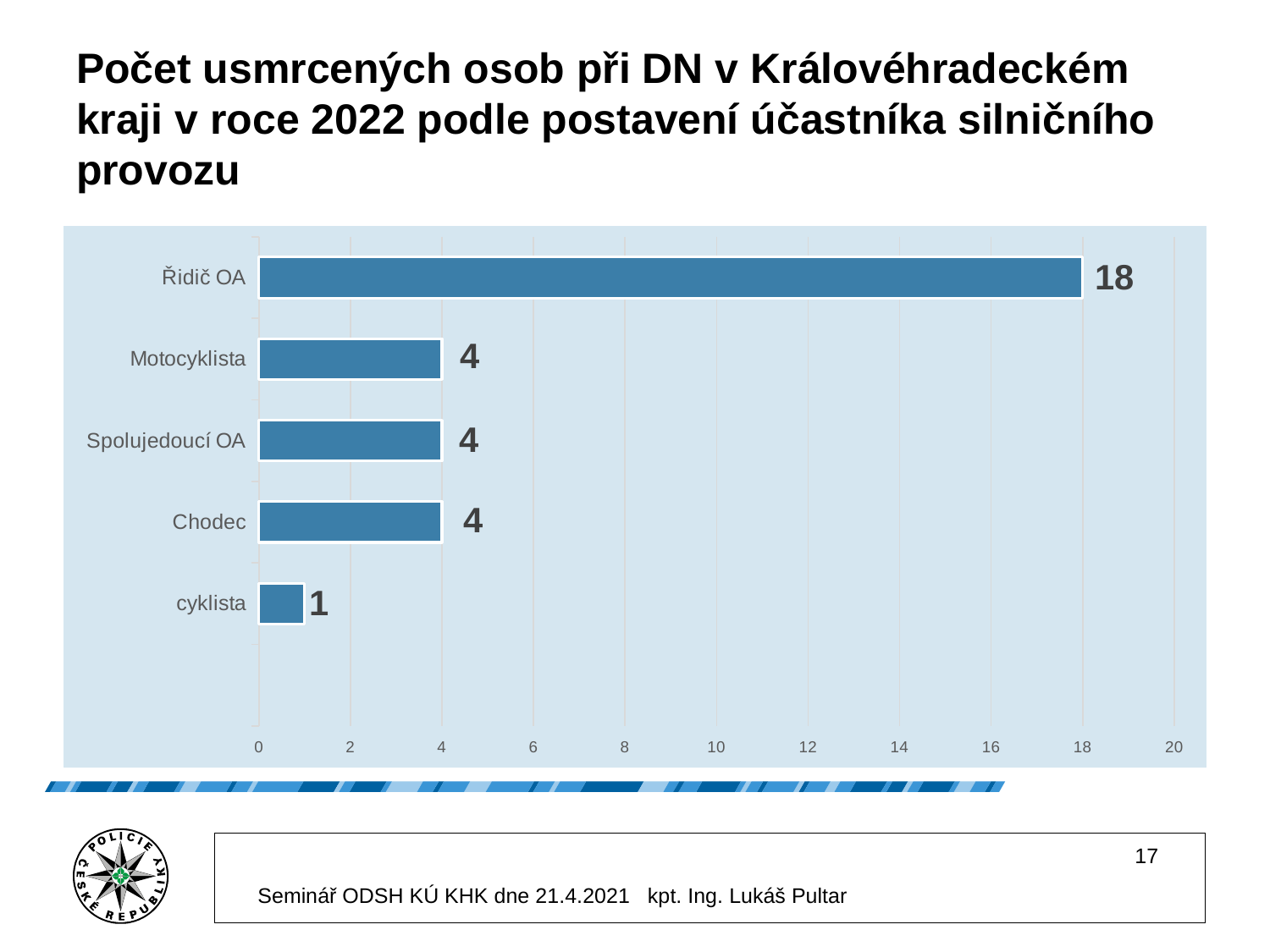
How many categories are shown in the chart? 5 What is the maximum value shown on the horizontal axis? 20 What is the value for Řidič OA? 18 What kind of chart is shown on the slide? bar chart What is the difference between the values for Spolujedoucí OA and cyklista? 3 Is the value for Řidič OA greater or less than 10? greater Which is larger, the value for Řidič OA or the value for Chodec? Řidič OA Which category has the highest value? Řidič OA What is the value for Chodec? 4 Which category has the lowest value? cyklista What is the value for cyklista? 1 What is the difference between the values for Řidič OA and Motocyklista? 14